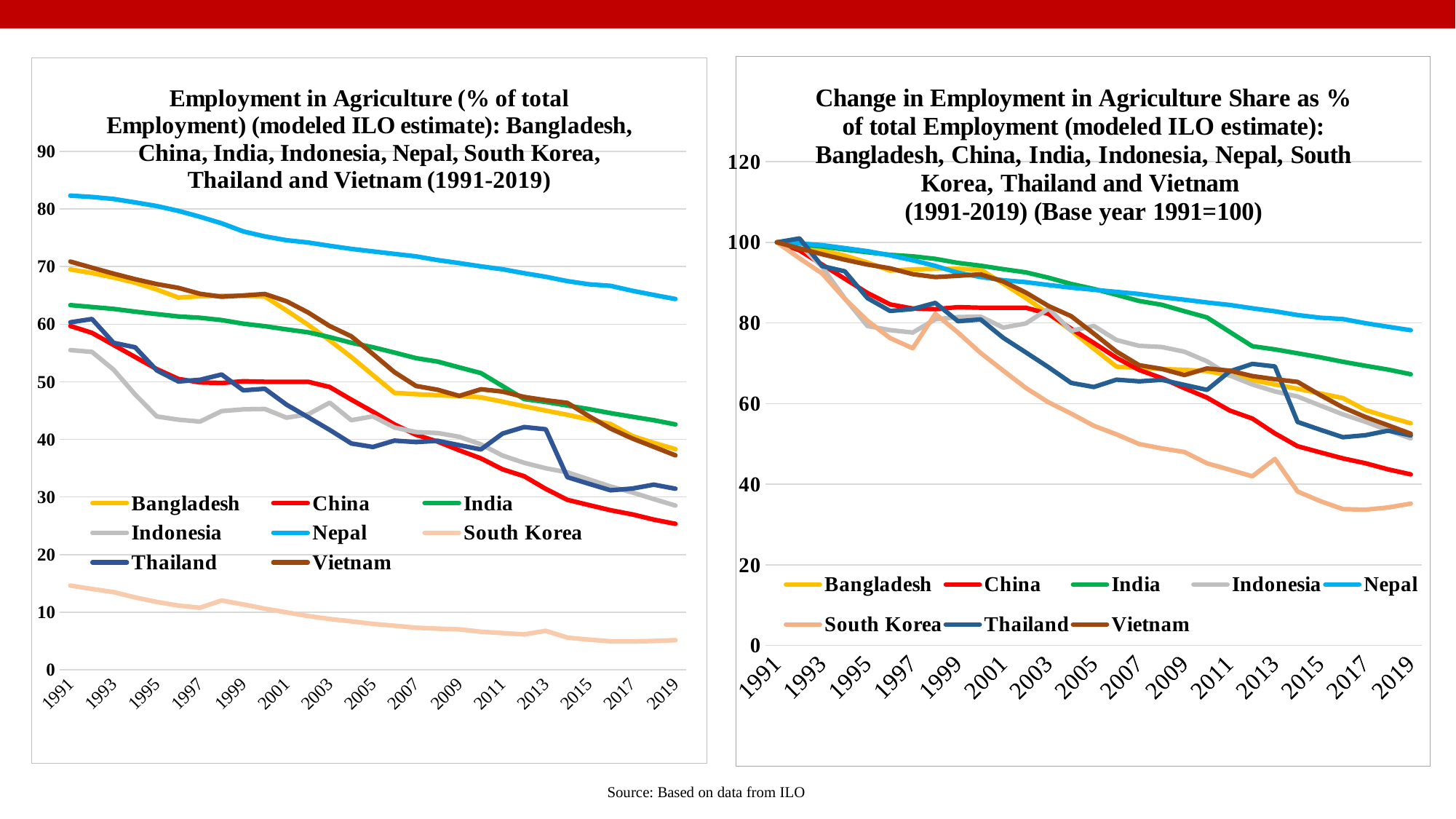
What kind of chart is the left chart, 'Employment in Agriculture (% of total Employment)'? line chart In the left chart, is the value for Nepal in 1991 greater or less than 80? greater In the left chart, which country has the lowest employment in agriculture share across the whole period? South Korea In the left chart, which country has the highest employment in agriculture share across the whole period? Nepal In the right chart, what is the base year used for the index of 100? 1991 In the left chart, is the value for South Korea in 2019 greater or less than 10? less In the left chart, is the value for China in 2019 greater or less than 30? less How many series does the legend of the left chart list? 8 In the left chart, does the value for India rise or fall from 1991 to 2019? fall In the right chart, 'Change in Employment in Agriculture Share', which country has the lowest value in 2019? South Korea In the left chart, which is larger in 2019, the value for India or the value for China? India